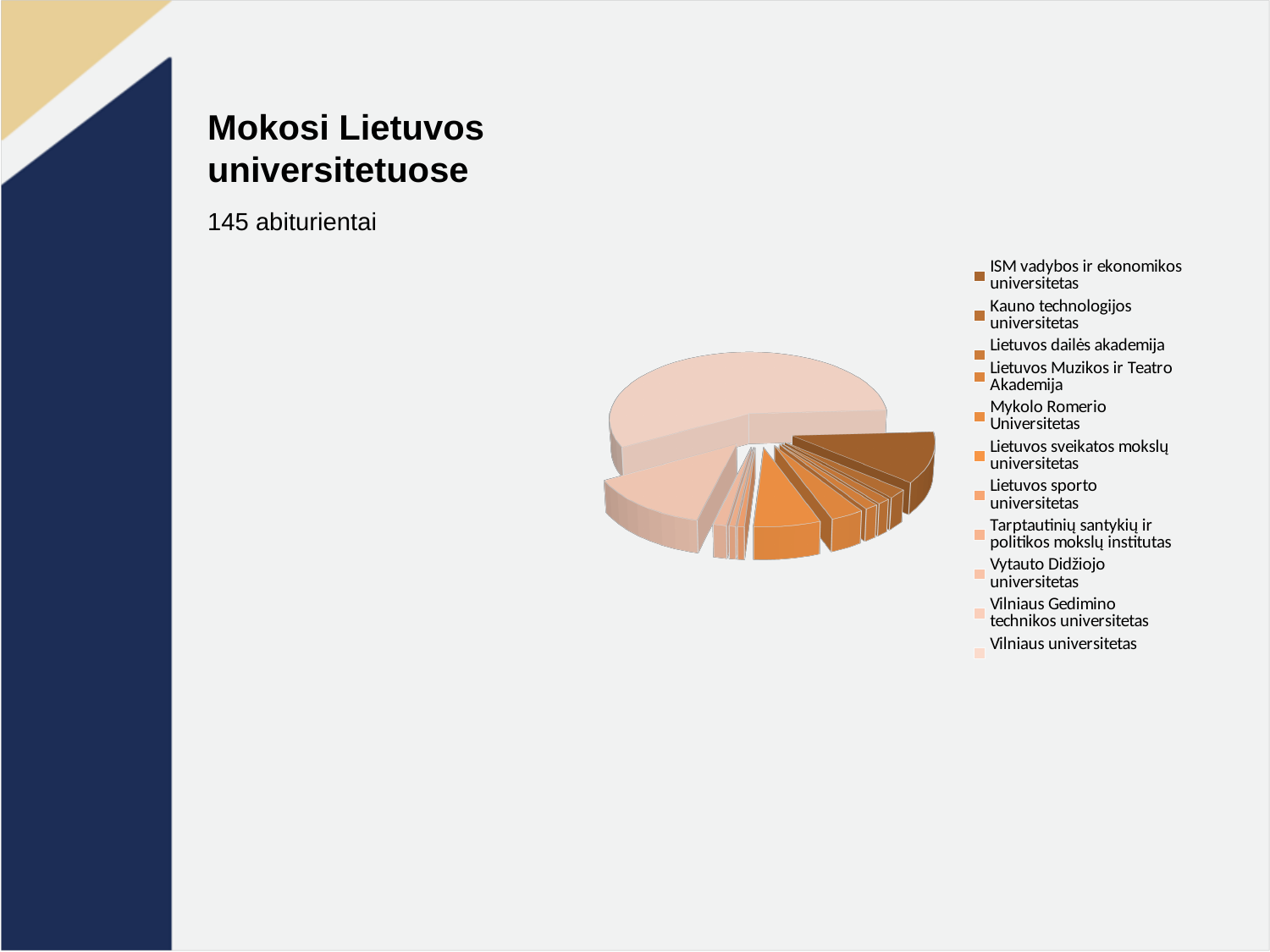
Which category has the largest slice in the pie chart? Vilniaus universitetas Which slice is larger: Vilniaus universitetas or ISM vadybos ir ekonomikos universitetas? Vilniaus universitetas How many categories does the legend of the pie chart list? 11 What is the title of the slide containing the pie chart? Mokosi Lietuvos universitetuose What kind of chart is shown on the slide? pie chart Which category is listed first in the pie chart's legend? ISM vadybos ir ekonomikos universitetas